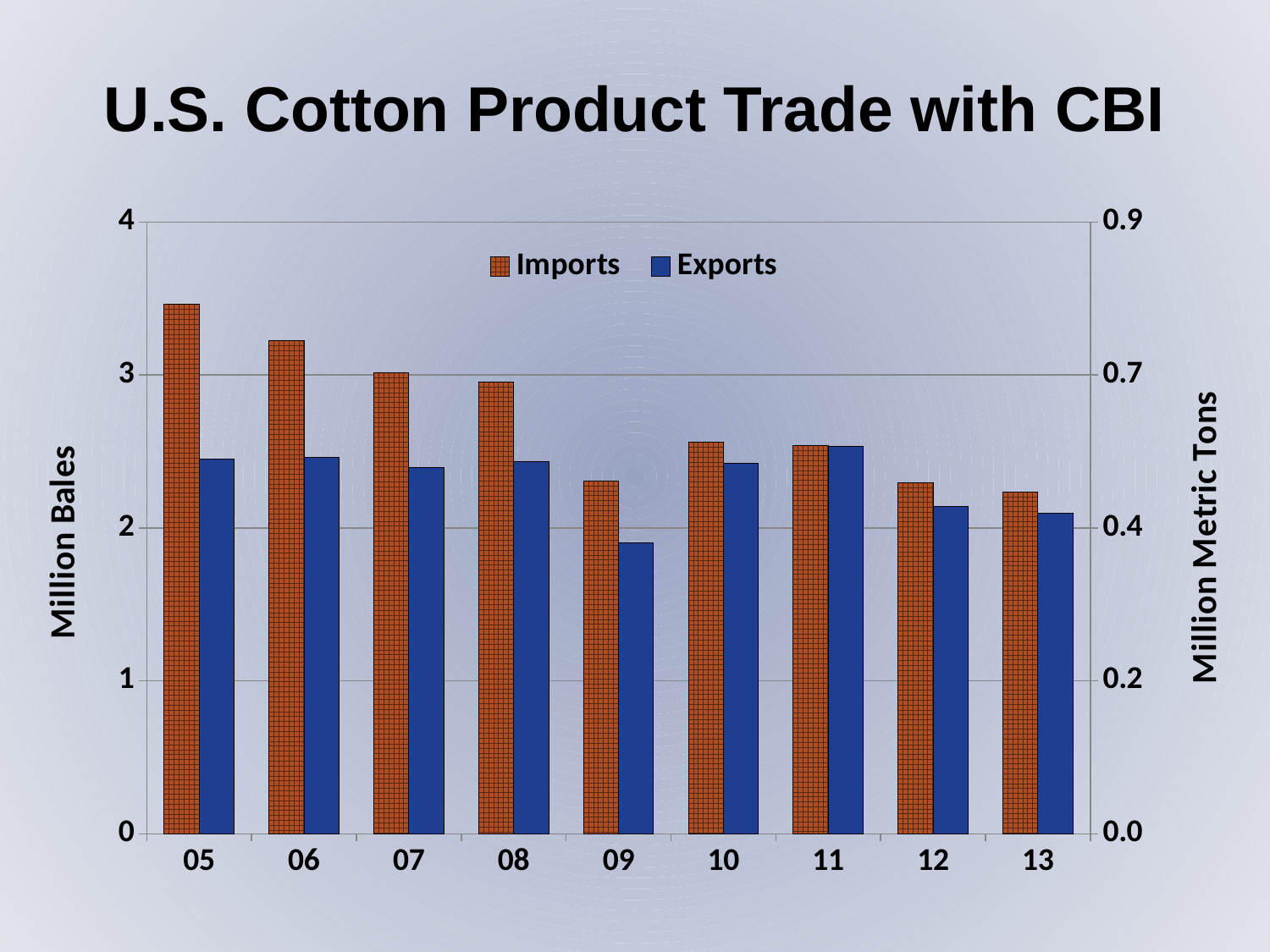
In 05, which is larger, Imports or Exports? Imports Which year has the highest Imports value? 05 How many series does the legend list? 2 Is the Imports value for 06 greater or less than 3 on the left axis? greater What kind of chart is shown on the slide? bar chart Is the Exports value for 09 greater or less than 2 on the left axis? less How many years are shown on the x axis? 9 Do the Imports values generally rise or fall from 05 to 13? fall What is the label on the right-hand vertical axis? Million Metric Tons In 09, which is larger, Imports or Exports? Imports Which year has the lowest Exports value? 09 Is the Imports value for 05 greater or less than 3 million bales? greater